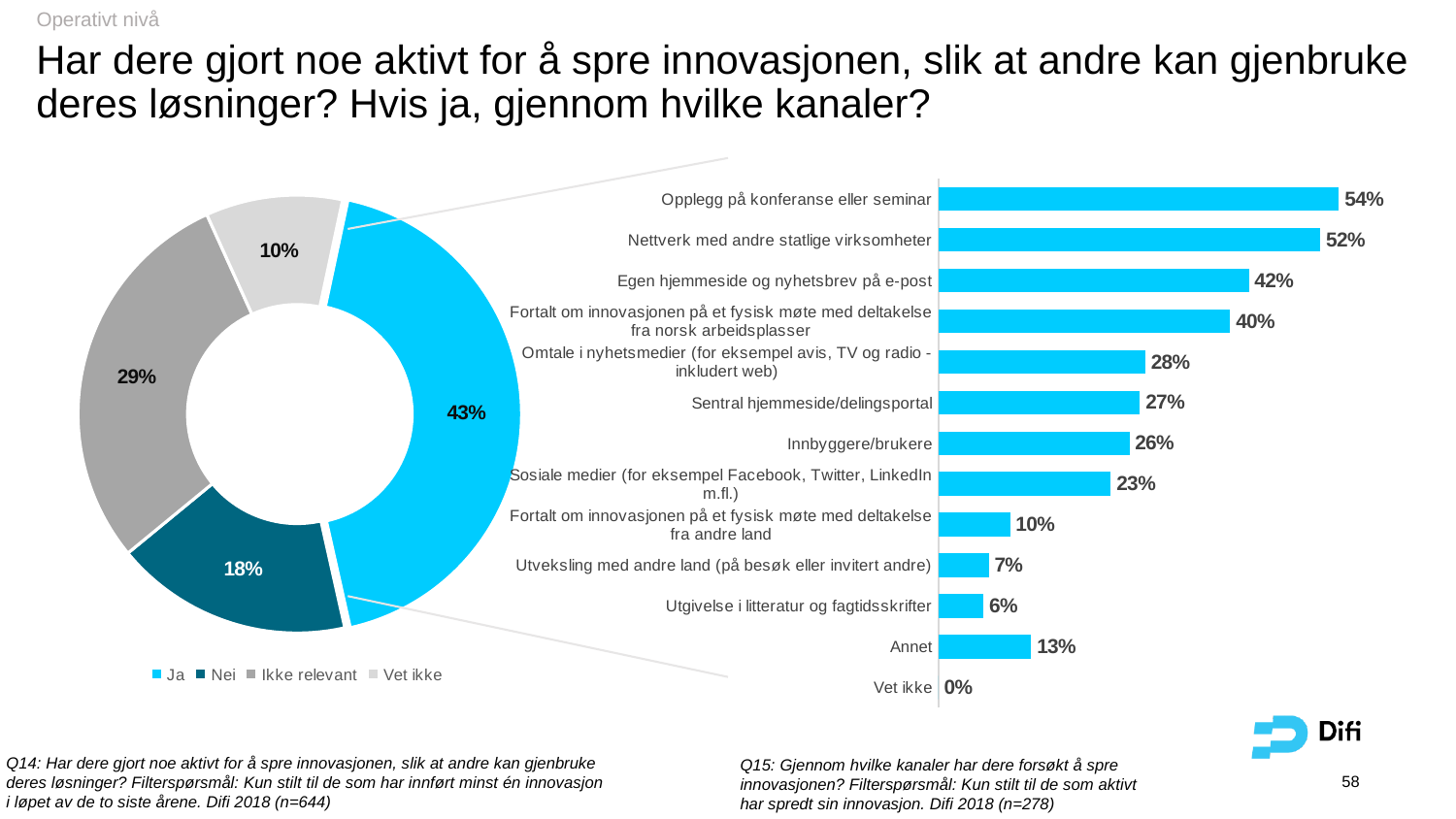
In the doughnut chart on the left, what share of respondents answered "Ikke relevant"? 29% In the doughnut chart on the left, what share of respondents answered "Ja"? 43% In the bar chart on the right, what is the value for "Opplegg på konferanse eller seminar"? 54% In the doughnut chart on the left, how many categories does the legend list? 4 In the bar chart on the right, what is the difference between "Nettverk med andre statlige virksomheter" and "Sosiale medier (for eksempel Facebook, Twitter, LinkedIn m.fl.)"? 29 percentage points What type of chart is shown on the right side of the slide? Bar chart In the bar chart on the right, what is the value for "Sentral hjemmeside/delingsportal"? 27% In the doughnut chart on the left, what is the difference between the "Ja" and "Nei" shares? 25 percentage points In the bar chart on the right, which is larger: "Egen hjemmeside og nyhetsbrev på e-post" or "Innbyggere/brukere"? Egen hjemmeside og nyhetsbrev på e-post In the doughnut chart on the left, which category has the smallest share? Vet ikke In the bar chart on the right, which category has the highest value? Opplegg på konferanse eller seminar In the bar chart on the right, how many categories are shown? 13